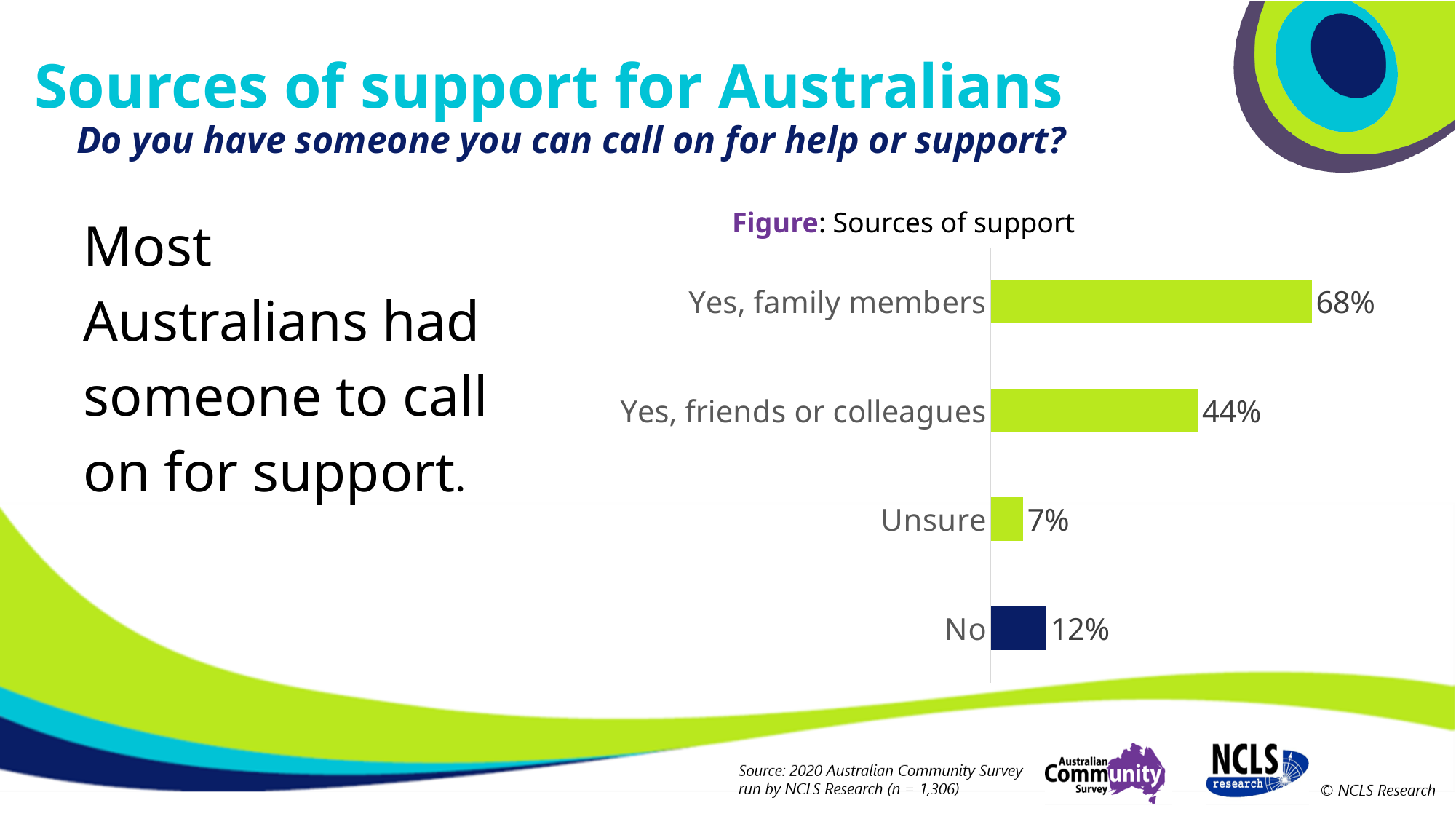
What is the value for 'Yes, friends or colleagues'? 44% Which category has the highest value? Yes, family members Which category's bar is coloured dark blue rather than green? No What percentage of respondents said they have family members they can call on for support? 68% What percentage of respondents answered 'No'? 12% What is the difference between the values for 'Yes, family members' and 'Yes, friends or colleagues'? 24% Which category has the lowest value? Unsure How many categories are shown in the chart? 4 Which is larger: the value for 'No' or the value for 'Unsure'? No What percentage of respondents answered 'Unsure'? 7% What kind of chart is shown on the slide? Bar chart What is the title of the figure? Sources of support